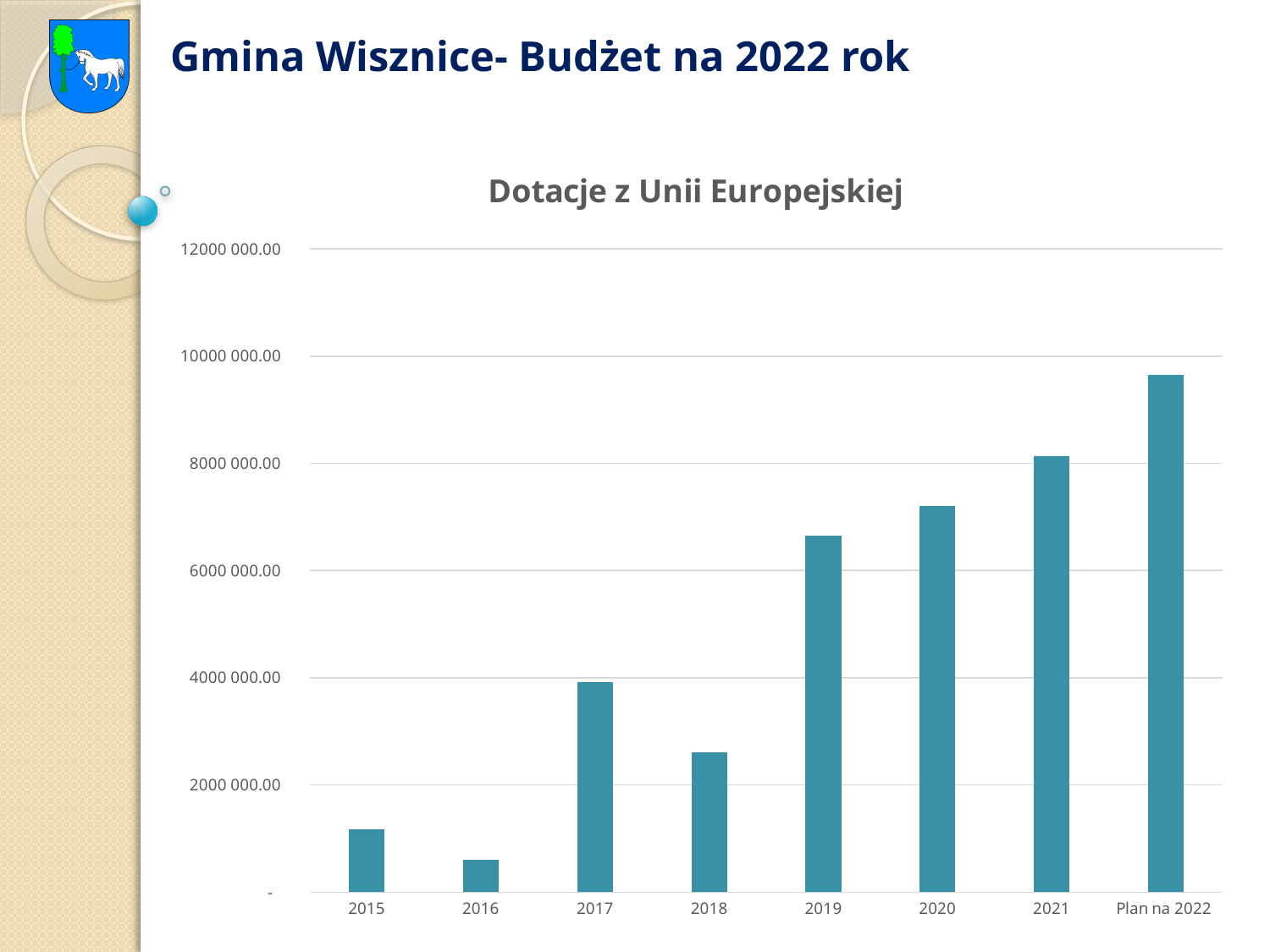
How many categories are shown on the x axis of the chart? 8 Which is larger, the value for 2020 or the value for 2021? 2021 Is the value for 2019 greater or less than 6000 000.00? greater Is the value for Plan na 2022 greater or less than 10000 000.00? less Which year has the lowest value in the chart? 2016 Is the value for 2015 greater or less than 2000 000.00? less What is the title of the chart? Dotacje z Unii Europejskiej Do the values rise or fall from 2018 to Plan na 2022? rise What kind of chart is shown on the slide? bar chart Which is larger, the value for 2017 or the value for 2018? 2017 Which category has the highest value in the chart? Plan na 2022